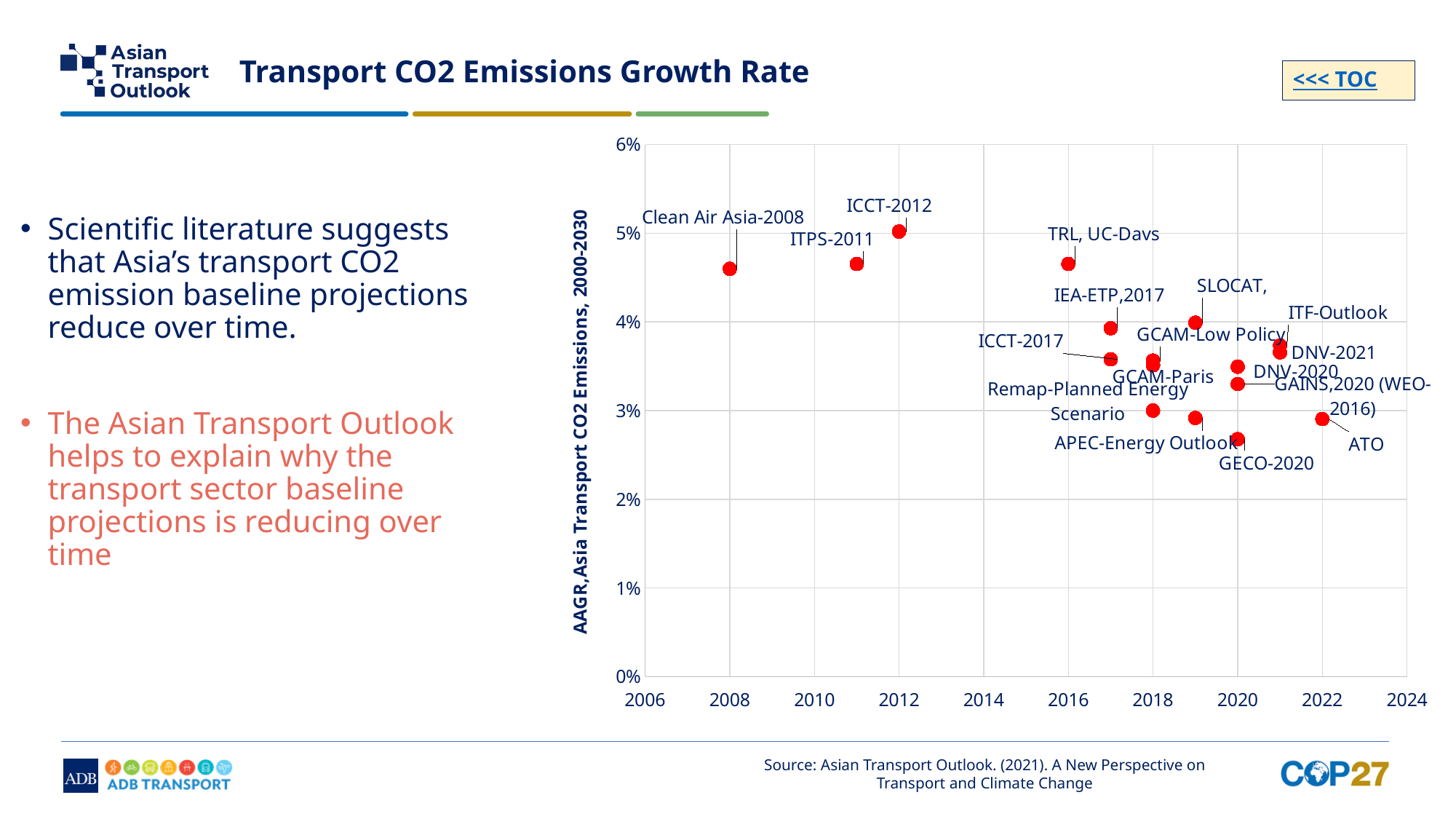
Is the value for ICCT-2012 greater or less than 4%? greater Which has a higher value, TRL, UC-Davs or ATO? TRL, UC-Davs Is the value for Clean Air Asia-2008 greater or less than 4%? greater Do the plotted values generally rise or fall as the year increases along the x axis? fall What is the highest value shown on the vertical axis? 6% Is the value for GECO-2020 greater or less than 3%? less Which point has the highest AAGR value on the chart? ICCT-2012 What is the label of the vertical axis? AAGR,Asia Transport CO2 Emissions, 2000-2030 What kind of chart is shown on the slide? scatter chart Which has a higher value, ICCT-2012 or GECO-2020? ICCT-2012